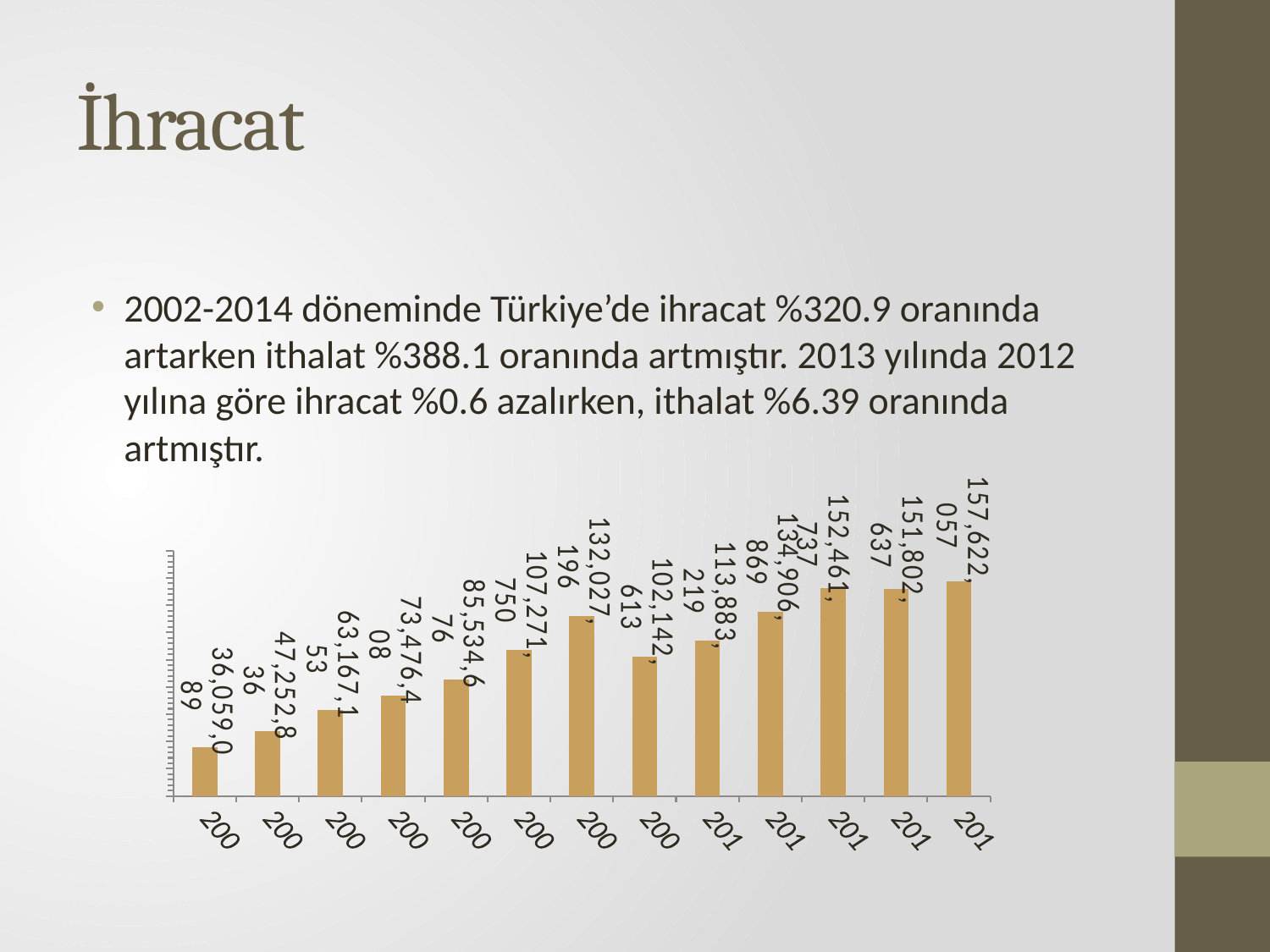
Which bar has the highest value in the chart? the last (rightmost) bar, 157,622,057 What colour are the bars in the chart? tan/gold What is the value shown on the eighth bar from the left? 102,142,613 How many bars does the chart contain? 13 What kind of chart is shown on the slide? bar chart What is the value shown on the first (leftmost) bar of the chart? 36,059,089 What is the value shown on the last (rightmost) bar of the chart? 157,622,057 Which bar has the lowest value in the chart? the first (leftmost) bar, 36,059,089 What is the value shown on the seventh bar from the left? 132,027,196 Which is larger, the value of the seventh bar (132,027,196) or the eighth bar (102,142,613)? the seventh bar Do the bar values generally rise or fall from left to right across the chart? rise What is the difference between the value of the last bar and the value of the first bar? 121,562,968